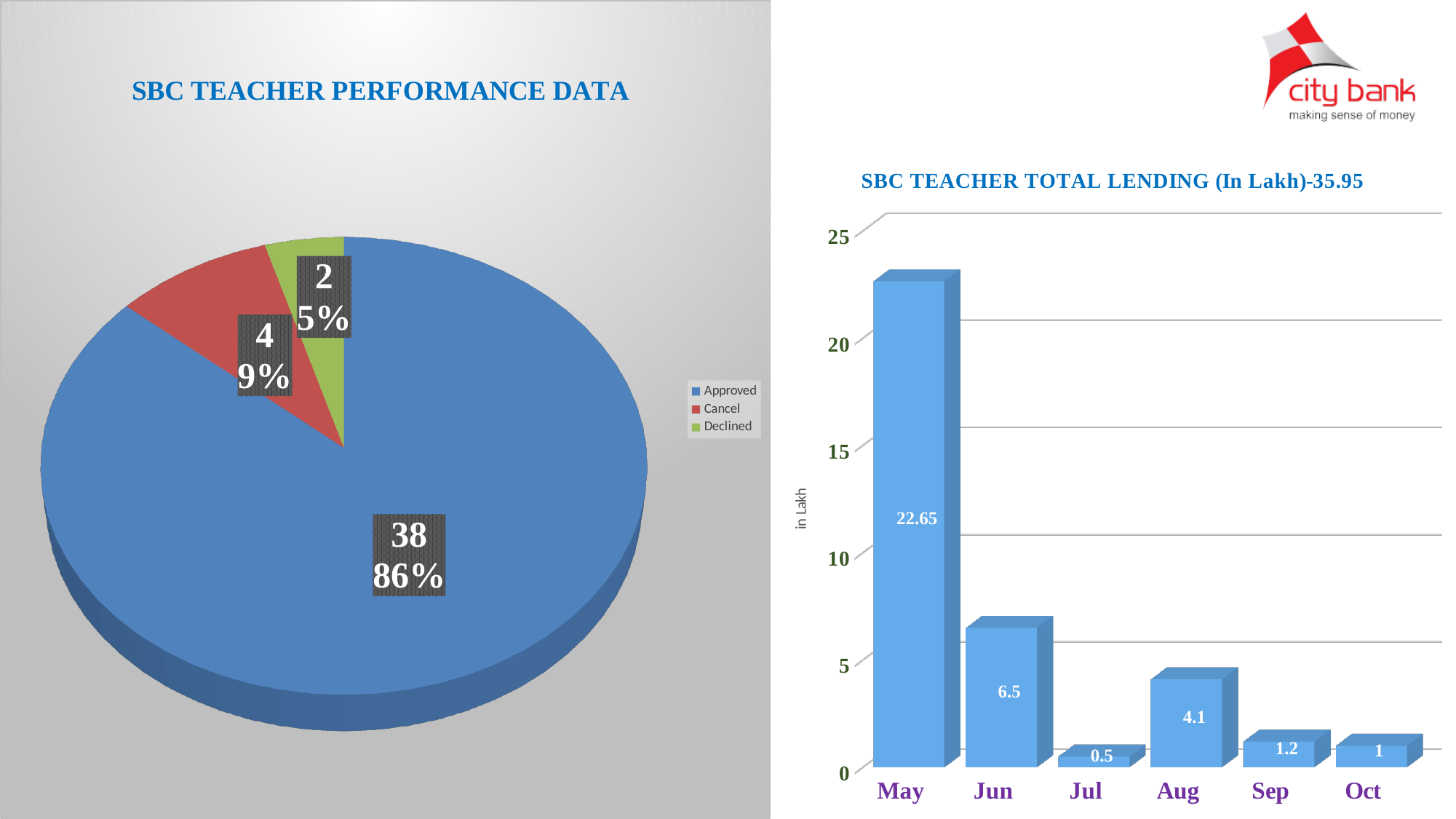
In the SBC TEACHER PERFORMANCE DATA pie chart, what share of the pie is Cancel? 9% In the SBC TEACHER PERFORMANCE DATA pie chart, what share of the pie is Declined? 5% In the SBC TEACHER TOTAL LENDING chart, which is larger, Sep or Oct? Sep In the SBC TEACHER TOTAL LENDING chart, what is the value for Aug? 4.1 In the SBC TEACHER PERFORMANCE DATA pie chart, which category is the smallest? Declined In the SBC TEACHER PERFORMANCE DATA pie chart, how many categories does the legend list? 3 In the SBC TEACHER PERFORMANCE DATA pie chart, what is the value for Approved? 38 In the SBC TEACHER TOTAL LENDING chart, what is the value for May? 22.65 In the SBC TEACHER TOTAL LENDING chart, which month has the lowest value? Jul In the SBC TEACHER TOTAL LENDING chart, what is the difference between May and Jun? 16.15 What kind of chart is the SBC TEACHER TOTAL LENDING chart? Bar chart What kind of chart is the SBC TEACHER PERFORMANCE DATA chart? Pie chart